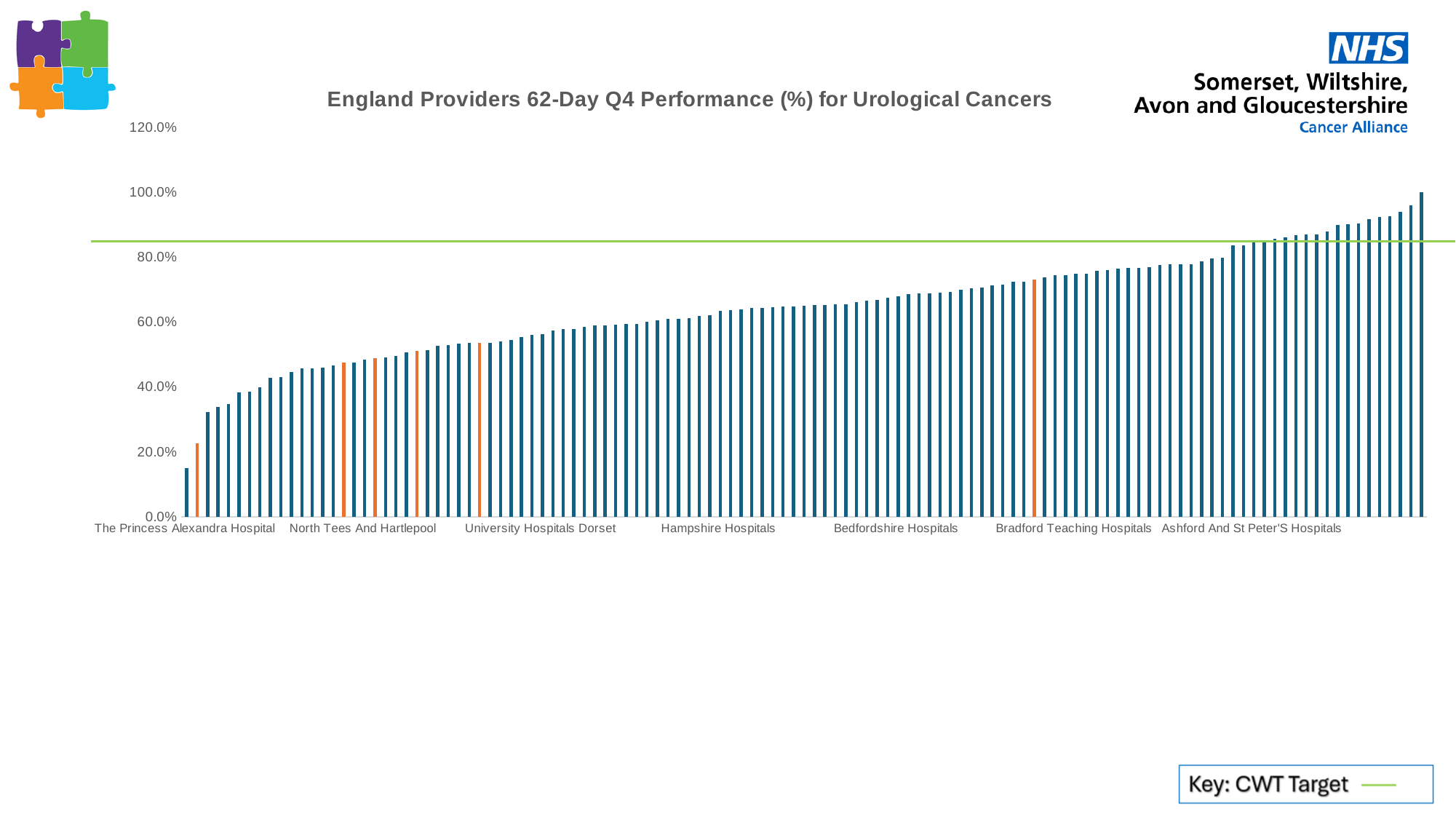
Which has the larger value, North Tees And Hartlepool or Hampshire Hospitals? Hampshire Hospitals Is the value for North Tees And Hartlepool greater or less than 60.0%? less Do the bar values rise or fall from left to right along the x axis? rise Is the value for Bradford Teaching Hospitals greater or less than 80.0%? less What kind of chart is shown on the slide? bar chart What is the title of the chart? England Providers 62-Day Q4 Performance (%) for Urological Cancers Is the value for Bedfordshire Hospitals greater or less than 60.0%? greater According to the key, what does the green horizontal line on the chart represent? CWT Target Which has the larger value, The Princess Alexandra Hospital or Bradford Teaching Hospitals? Bradford Teaching Hospitals